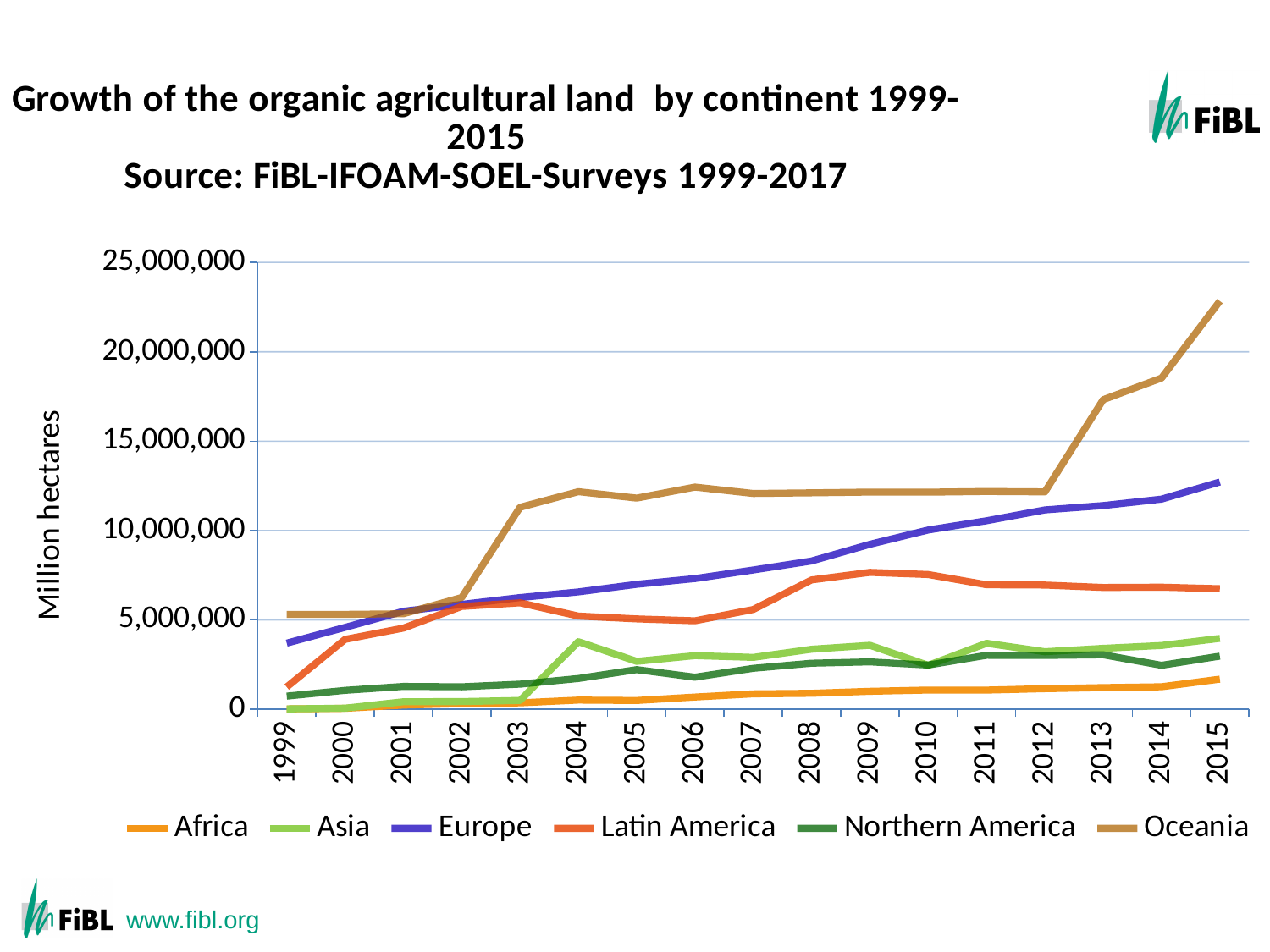
In 2015, which is larger, the value for Europe or the value for Latin America? Europe Which continent has the highest organic agricultural land in 2015? Oceania How many years are shown along the x axis? 17 Which continent has the lowest organic agricultural land in 2015? Africa Does the value for Europe rise or fall from 1999 to 2015? Rise Is the value for Europe in 2015 greater or less than 10,000,000? greater Is the value for Oceania in 2002 greater or less than 10,000,000? less How many series does the legend list? 6 What kind of chart is shown on the slide? Line chart Is the value for Oceania in 2015 greater or less than 20,000,000? greater What is the label on the y axis? Million hectares